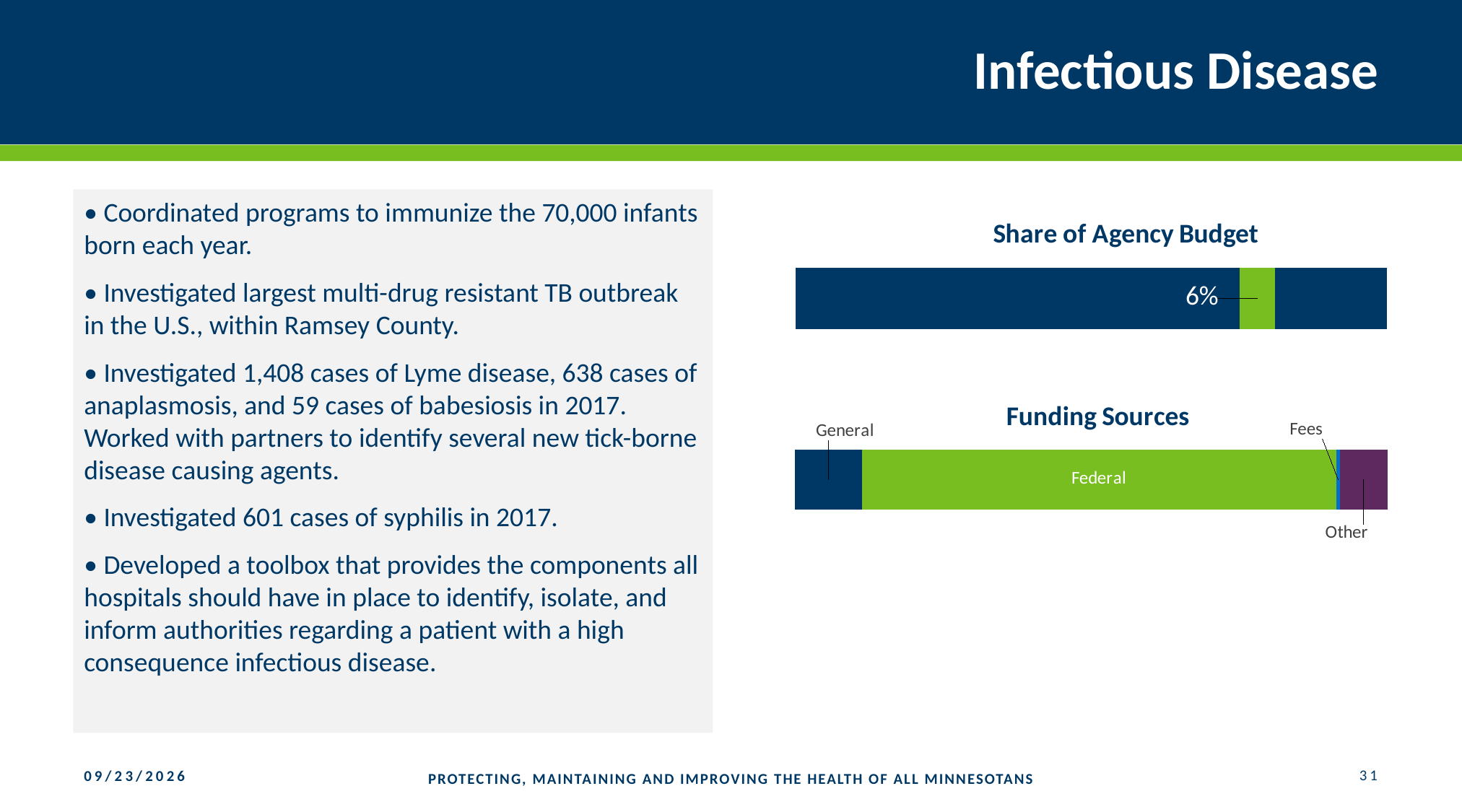
In the Funding Sources chart, what colour is the Federal segment? Green How many charts are shown on the slide? 2 In the Funding Sources chart, how many funding sources are shown? 4 In the Funding Sources chart, which funding source is the smallest? Fees In the Funding Sources chart, which is larger, Federal or General? Federal In the Funding Sources chart, which is larger, General or Other? General What kind of chart is the Share of Agency Budget chart? Bar chart What kind of chart is the Funding Sources chart? Bar chart In the Share of Agency Budget chart, what percentage is labelled on the highlighted segment? 6% What is the title of the upper chart on the right side of the slide? Share of Agency Budget In the Funding Sources chart, which funding source is the largest? Federal